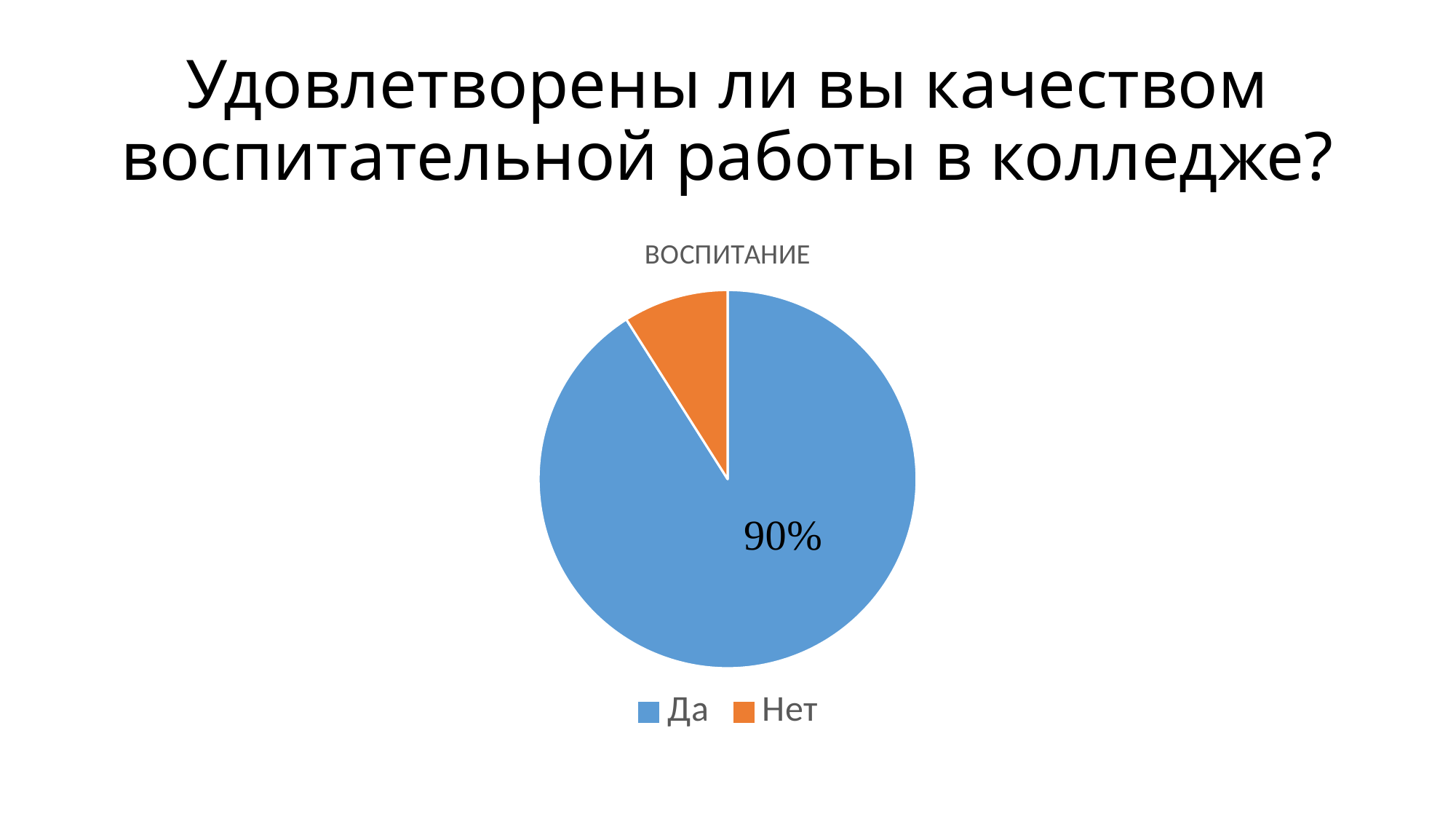
What value is printed on the "Да" slice? 90% Which slice is larger, "Да" or "Нет"? Да What colour is the "Нет" slice? orange Which category has the smallest slice of the pie? Нет How many entries does the legend list? 2 What share of the pie does the "Да" slice represent? 90% Which category has the largest slice of the pie? Да What is the title of the chart? ВОСПИТАНИЕ What kind of chart is shown on the slide? pie chart How many slices does the pie chart have? 2